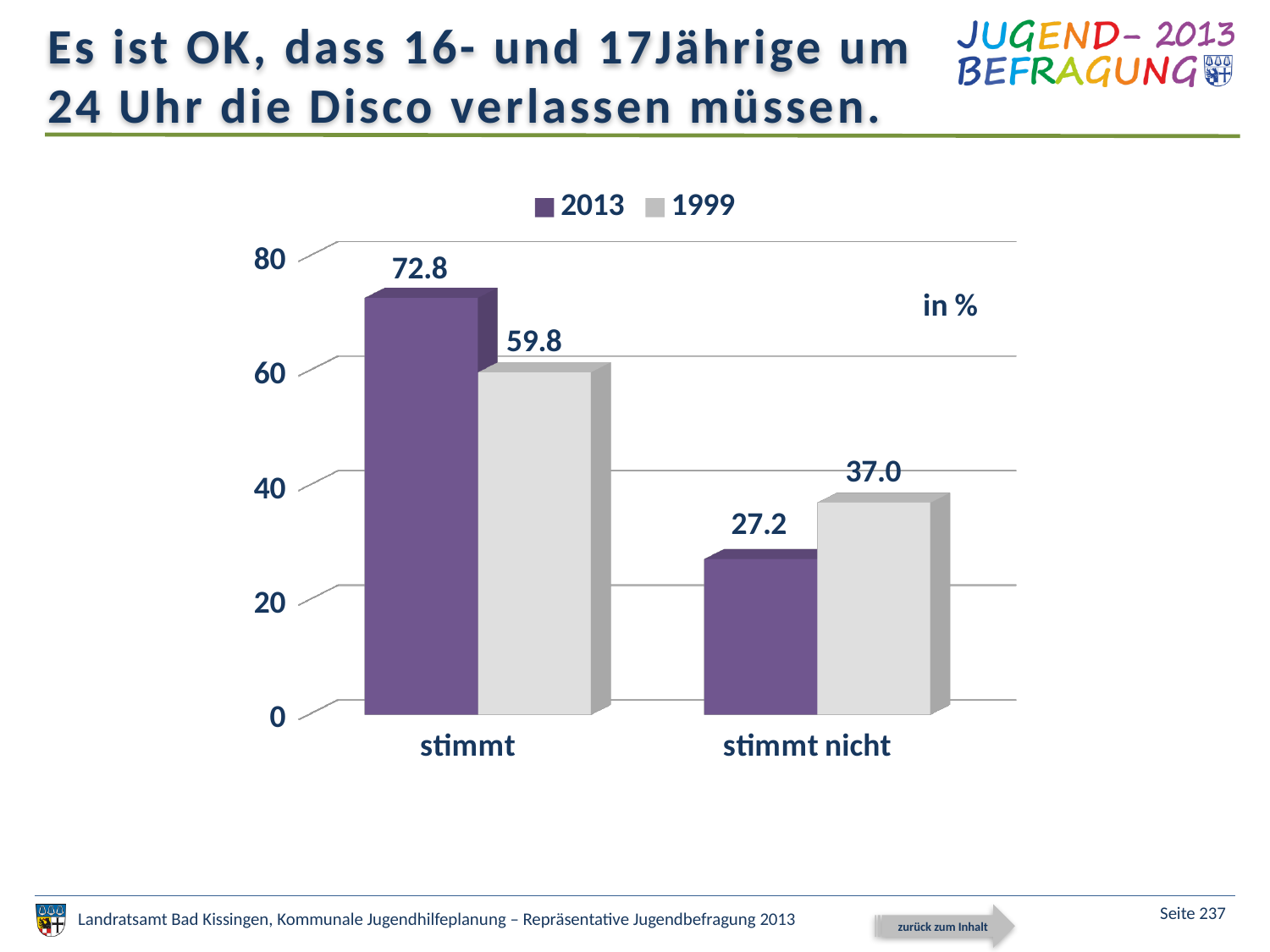
How many series does the legend list? 2 What is the value for 'stimmt' in the 1999 series? 59.8 What is the difference between the 2013 and 1999 values for 'stimmt'? 13.0 What is the value for 'stimmt' in the 2013 series? 72.8 What is the difference between the 1999 and 2013 values for 'stimmt nicht'? 9.8 What is the value for 'stimmt nicht' in the 1999 series? 37.0 What is the value for 'stimmt nicht' in the 2013 series? 27.2 How many categories are shown on the x axis? 2 Which category has the highest value in the 2013 series? stimmt For 'stimmt nicht', which series has the larger value, 2013 or 1999? 1999 Which category has the lowest value in the 1999 series? stimmt nicht What kind of chart is shown on the slide? bar chart